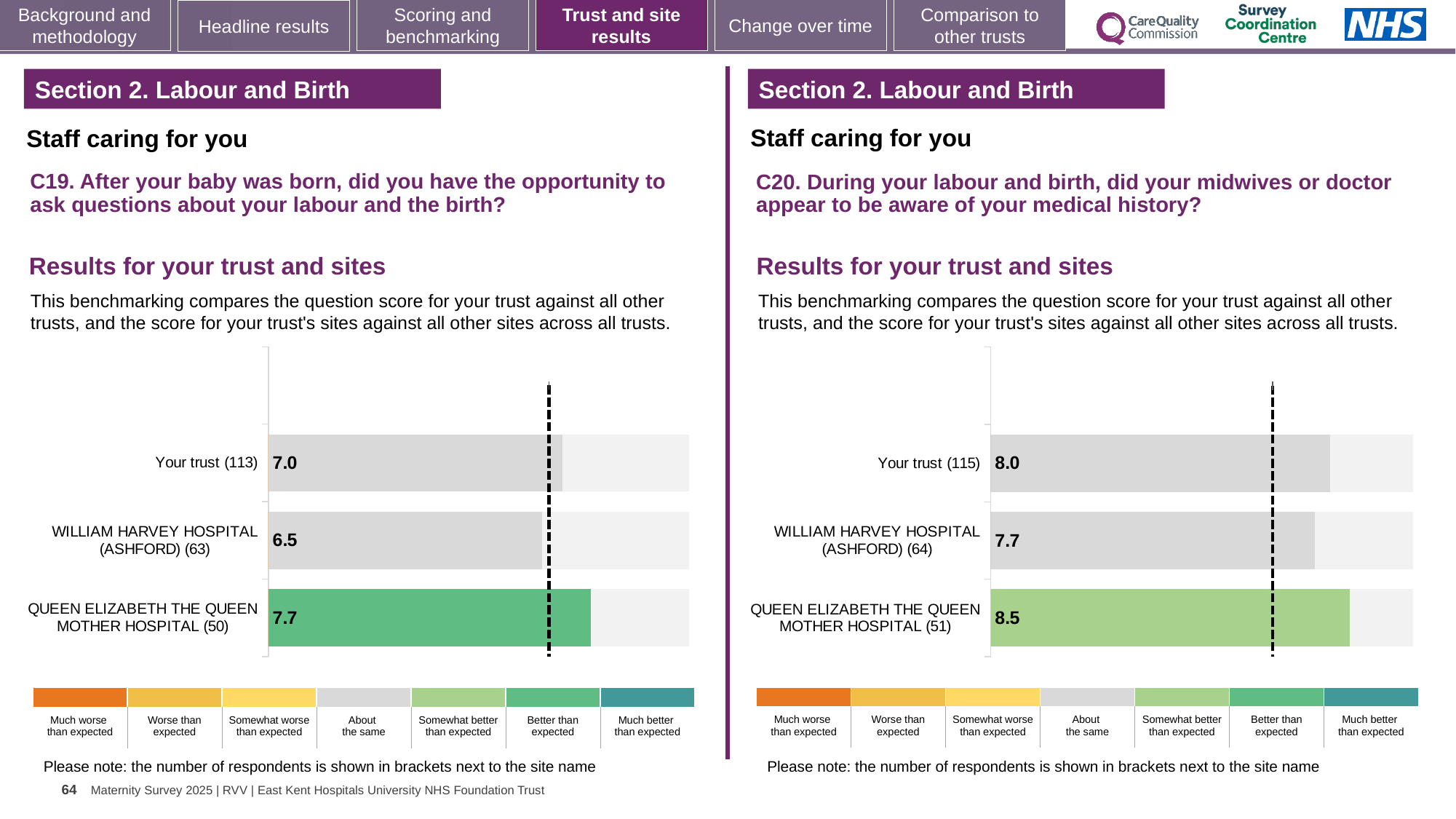
In the C20 chart on the right, which has the larger score: Your trust or WILLIAM HARVEY HOSPITAL (ASHFORD)? Your trust In the C19 chart on the left, which site or trust has the highest score? QUEEN ELIZABETH THE QUEEN MOTHER HOSPITAL (50) In the C19 chart on the left, which bar is coloured green rather than grey? QUEEN ELIZABETH THE QUEEN MOTHER HOSPITAL (50) In the C20 chart on the right, which site or trust has the lowest score? WILLIAM HARVEY HOSPITAL (ASHFORD) (64) In the C19 chart on the left, what is the difference between the scores for QUEEN ELIZABETH THE QUEEN MOTHER HOSPITAL and WILLIAM HARVEY HOSPITAL? 1.2 In the C19 chart on the left, what is the score for WILLIAM HARVEY HOSPITAL (ASHFORD) (63)? 6.5 How many bars are shown in the C19 chart on the left? 3 In the C20 chart on the right, what is the score for QUEEN ELIZABETH THE QUEEN MOTHER HOSPITAL (51)? 8.5 In the C20 chart on the right, what is the score for Your trust (115)? 8.0 What type of chart is used for the C20 results on the right? Bar chart In the C19 chart on the left, what is the score for Your trust (113)? 7.0 In the C20 chart on the right, what is the difference between the scores for QUEEN ELIZABETH THE QUEEN MOTHER HOSPITAL and Your trust? 0.5